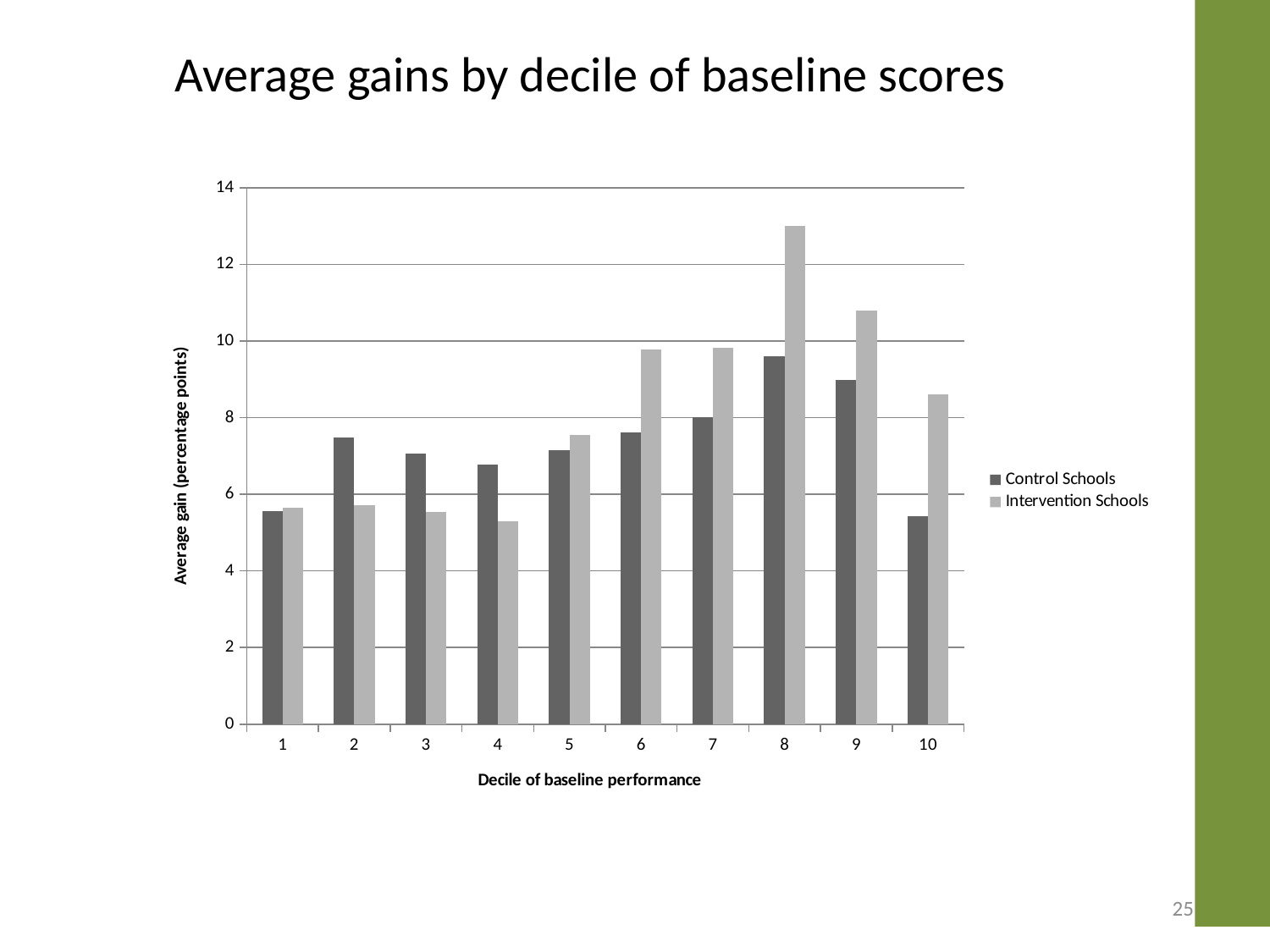
Is the Intervention Schools value for decile 4 greater or less than 6? less How many deciles are shown on the x axis? 10 Which decile has the highest value for Intervention Schools? 8 Is the Intervention Schools value for decile 8 greater or less than 12? greater Is the Control Schools value for decile 2 greater or less than 6? greater For decile 10, which series has the larger value, Control Schools or Intervention Schools? Intervention Schools What is the label of the y axis? Average gain (percentage points) Which decile has the highest value for Control Schools? 8 For decile 2, which series has the larger value, Control Schools or Intervention Schools? Control Schools What kind of chart is shown on the slide? bar chart How many series does the legend list? 2